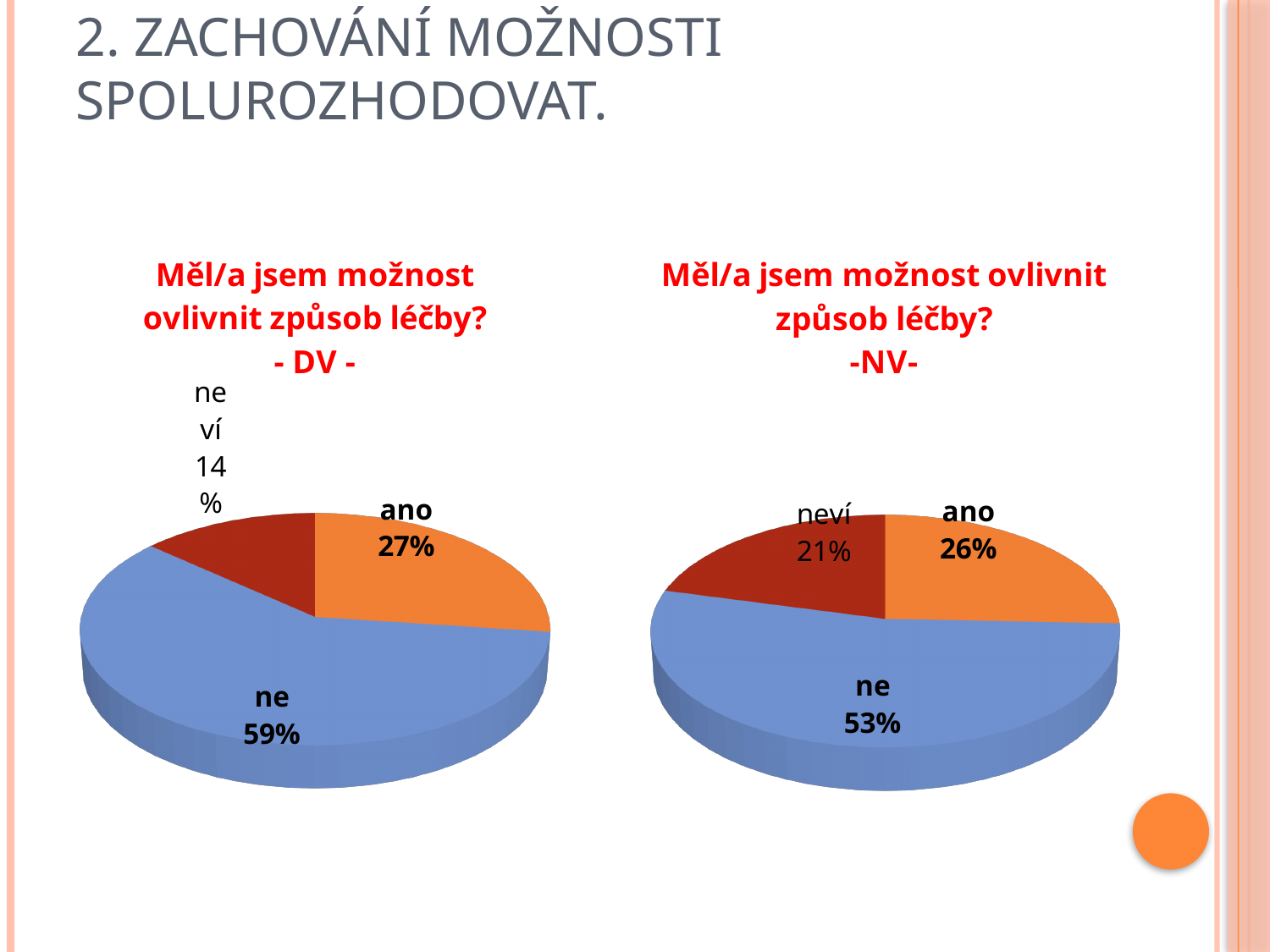
What type of chart is used on the left side of the slide? pie chart In the right pie chart (-NV-), what share of respondents answered "ne"? 53% In the left pie chart (- DV -), what share of respondents answered "ano"? 27% In the right pie chart (-NV-), what is the difference between the "ano" and "neví" shares? 5% Which chart has the larger share for "ne", the left (- DV -) or the right (-NV-)? left (- DV -) In the right pie chart (-NV-), which answer has the largest share? ne In the left pie chart (- DV -), which answer has the smallest share? neví In the left pie chart (- DV -), what share of respondents answered "ne"? 59% How many slices does the right pie chart (-NV-) have? 3 In the right pie chart (-NV-), what share of respondents answered "neví"? 21% In the left pie chart (- DV -), what is the difference between the "ne" and "ano" shares? 32% In the left pie chart (- DV -), what share of respondents answered "neví"? 14%